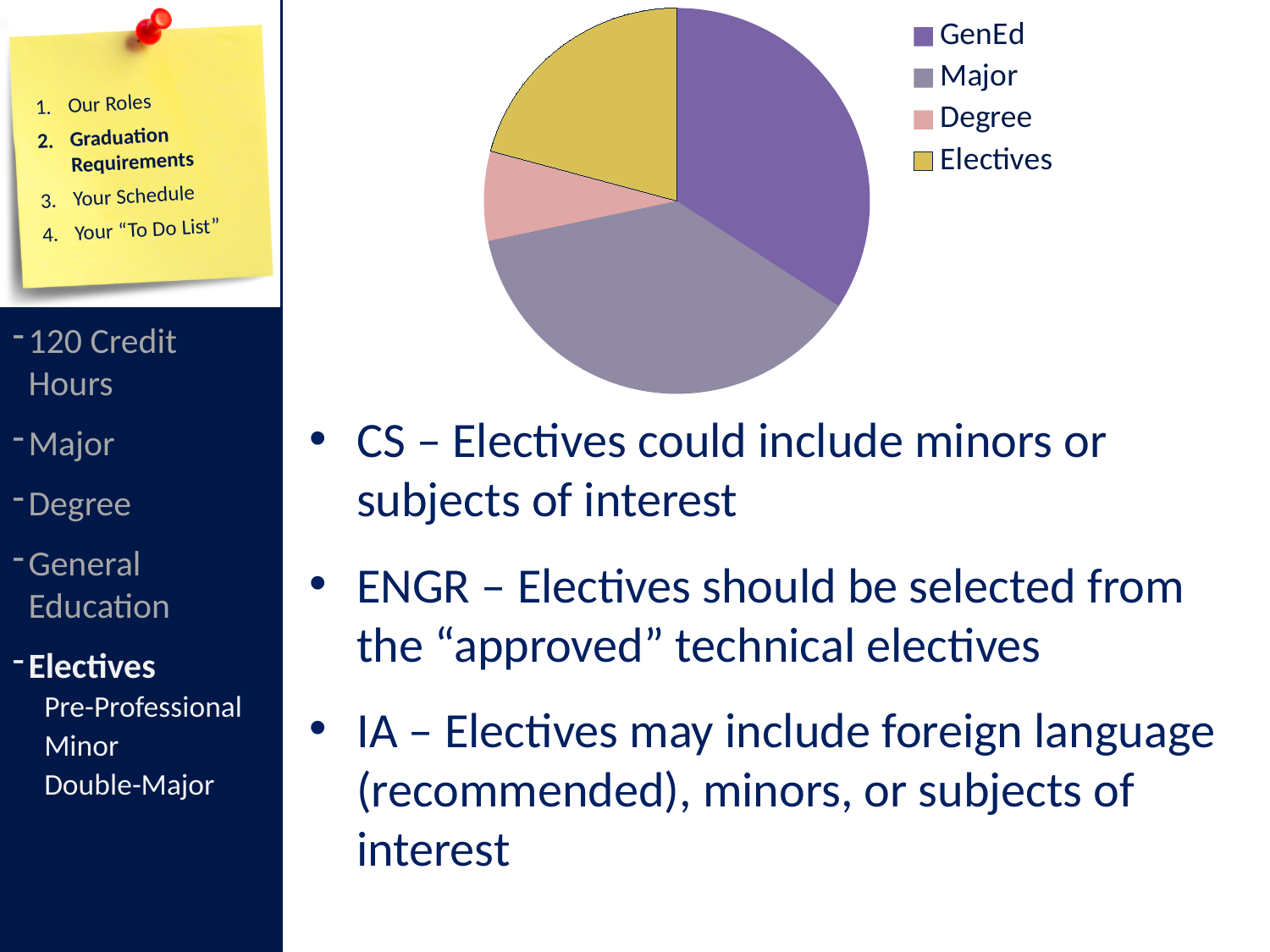
How many slices does the pie chart have? 4 Which category has the smallest slice in the pie chart? Degree Which slice is larger in the pie chart, Major or Degree? Major Which slice is larger in the pie chart, Electives or Degree? Electives Which slice is larger in the pie chart, Major or Electives? Major What colour is the Electives slice in the pie chart? yellow How many entries does the pie chart's legend list? 4 Which category is shown in purple in the pie chart? GenEd What kind of chart is shown on the slide? pie chart